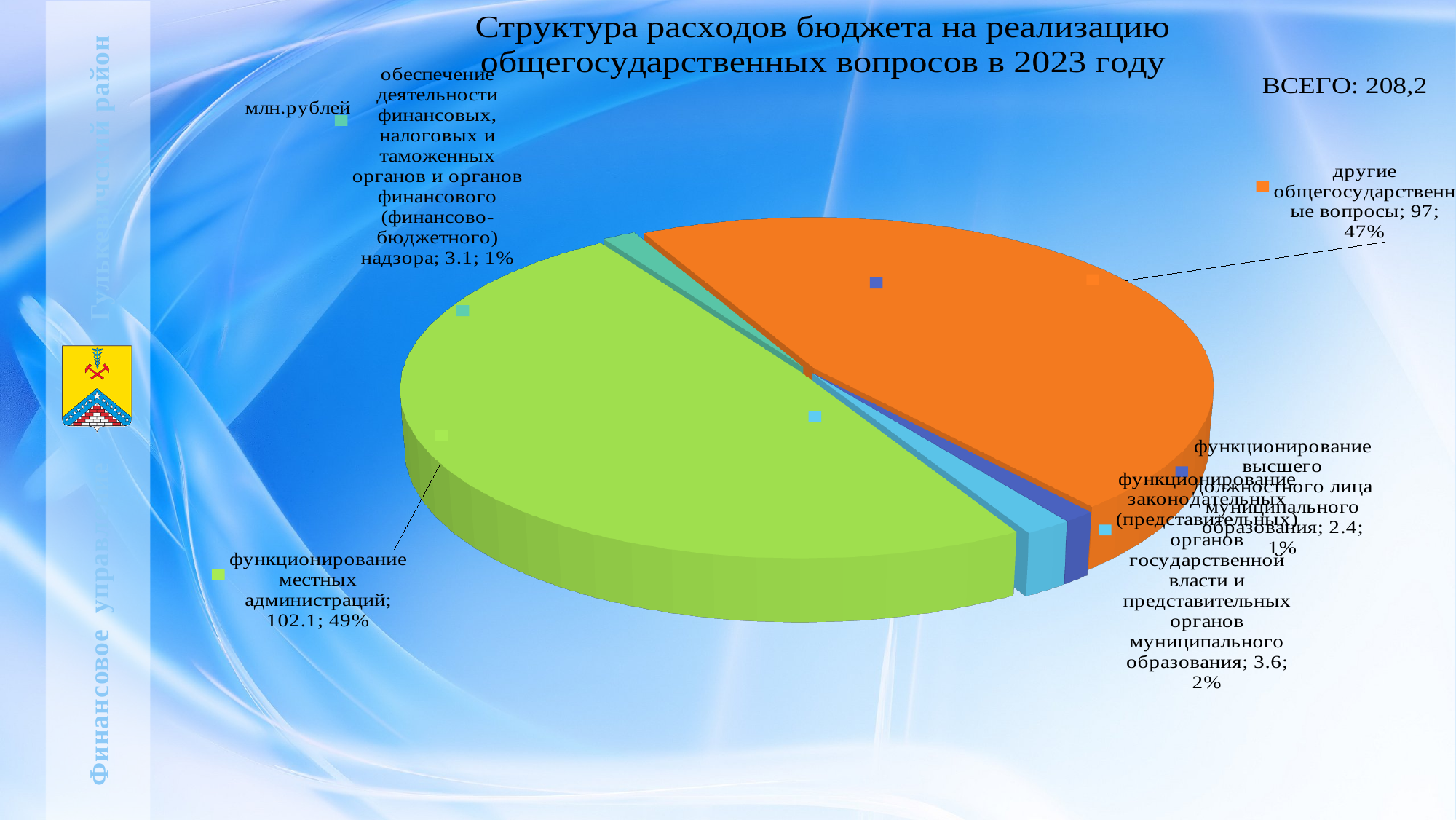
What kind of chart is shown on the slide? pie chart How many slices does the pie chart have? 5 What is the value for "функционирование высшего должностного лица муниципального образования"? 2.4 Which category has the smallest slice of the pie? функционирование высшего должностного лица муниципального образования Which is larger: the value for "функционирование законодательных (представительных) органов" or the value for "обеспечение деятельности финансовых, налоговых и таможенных органов"? функционирование законодательных (представительных) органов What share of the pie does "другие общегосударственные вопросы" take? 47% Which category has the largest slice of the pie? функционирование местных администраций What share of the pie does "функционирование законодательных (представительных) органов государственной власти и представительных органов муниципального образования" take? 2% What is the title of the chart? Структура расходов бюджета на реализацию общегосударственных вопросов в 2023 году What is the difference between the values for "функционирование местных администраций" and "другие общегосударственные вопросы"? 5.1 What total (ВСЕГО) is shown on the slide? 208,2 What is the value for "функционирование местных администраций"? 102.1